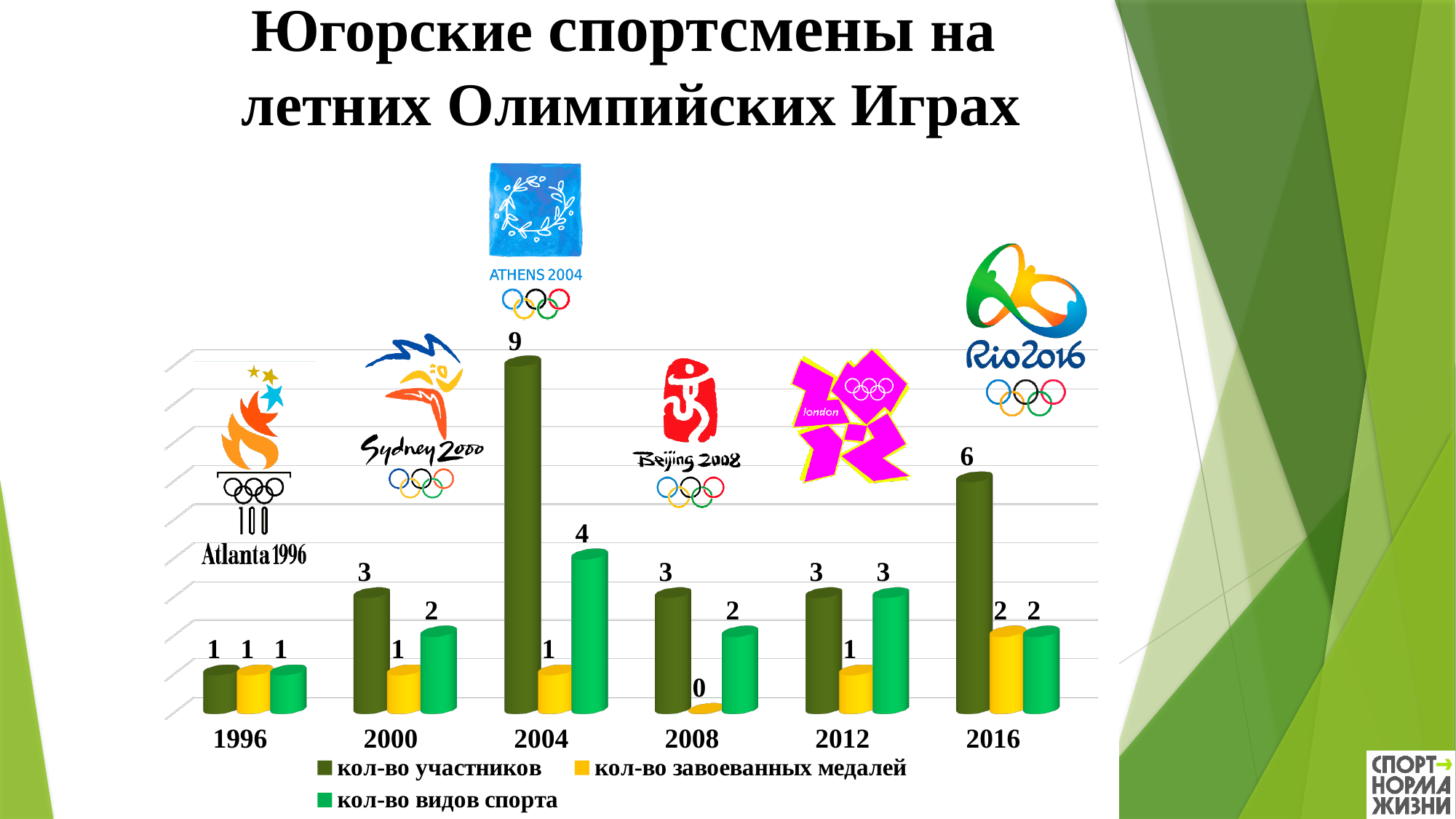
What type of chart is shown on the slide? bar chart How many years (categories) are shown on the x axis? 6 What is the value of 'кол-во завоеванных медалей' for 2008? 0 What is the value of 'кол-во участников' for 2004? 9 Which is larger: 'кол-во видов спорта' in 2004 or in 2016? 2004 In which year is 'кол-во участников' highest? 2004 How many series does the legend list? 3 In which year is 'кол-во завоеванных медалей' lowest? 2008 Which series is shown in yellow in the legend? кол-во завоеванных медалей What is the difference between 'кол-во участников' in 2004 and in 2016? 3 What is the value of 'кол-во завоеванных медалей' for 2016? 2 What is the value of 'кол-во видов спорта' for 2012? 3